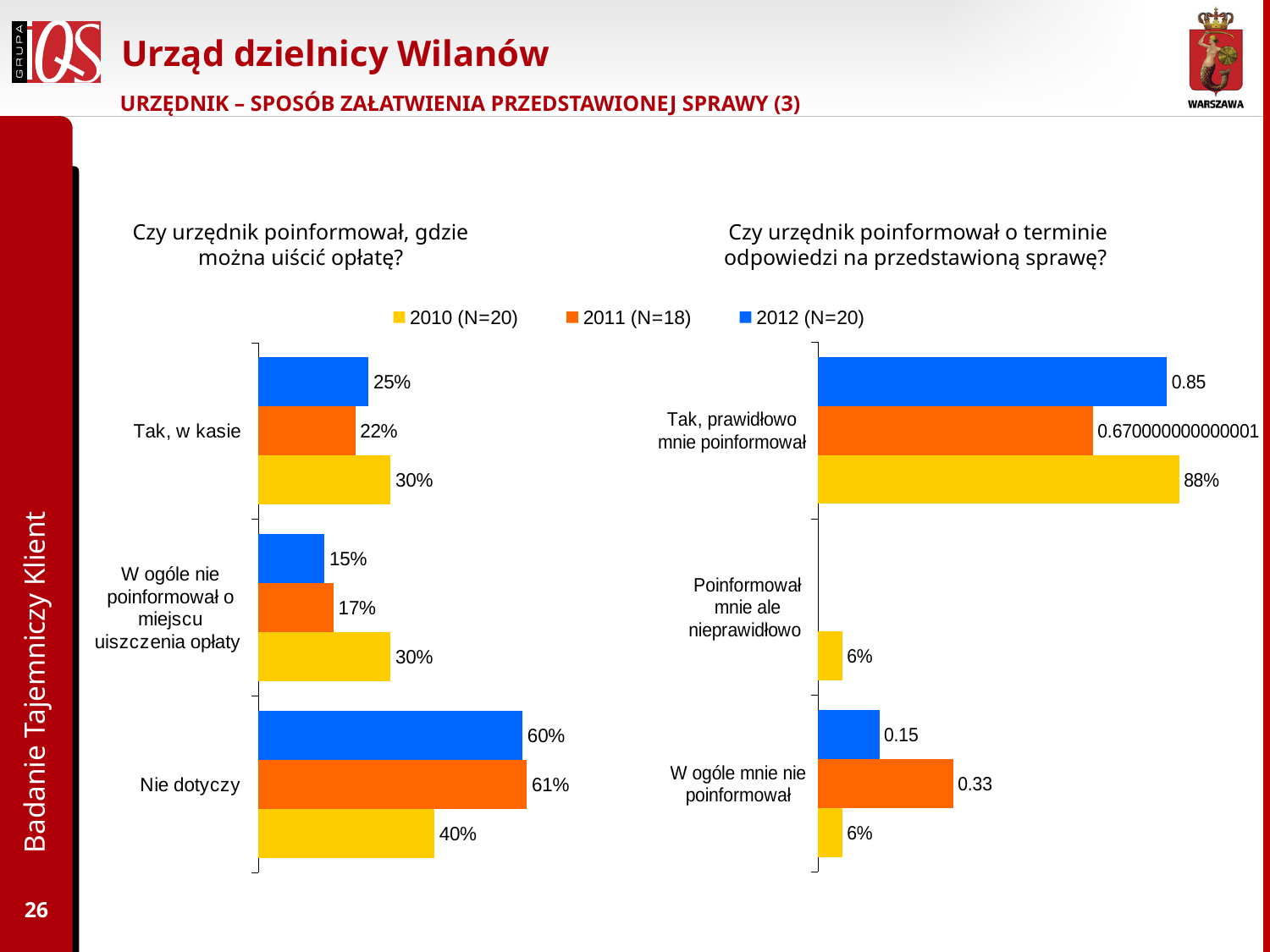
In the right chart (Czy urzędnik poinformował o terminie odpowiedzi na przedstawioną sprawę?), what is the value for 'Tak, prawidłowo mnie poinformował' in 2010 (N=20)? 88% In the left chart (Czy urzędnik poinformował, gdzie można uiścić opłatę?), what is the value for 'W ogóle nie poinformował o miejscu uiszczenia opłaty' in 2010 (N=20)? 30% In the left chart (Czy urzędnik poinformował, gdzie można uiścić opłatę?), what is the value for 'Nie dotyczy' in 2011 (N=18)? 61% In the left chart (Czy urzędnik poinformował, gdzie można uiścić opłatę?), which category has the lowest value for 2011 (N=18)? W ogóle nie poinformował o miejscu uiszczenia opłaty How many categories does the right chart (Czy urzędnik poinformował o terminie odpowiedzi na przedstawioną sprawę?) show? 3 In the left chart (Czy urzędnik poinformował, gdzie można uiścić opłatę?), what is the value for 'Tak, w kasie' in 2012 (N=20)? 25% What kind of chart is the left chart (Czy urzędnik poinformował, gdzie można uiścić opłatę?)? Bar chart In the right chart (Czy urzędnik poinformował o terminie odpowiedzi na przedstawioną sprawę?), what is the value for 'W ogóle mnie nie poinformował' in 2011 (N=18)? 0.33 In the left chart (Czy urzędnik poinformował, gdzie można uiścić opłatę?), which category has the highest value for 2012 (N=20)? Nie dotyczy In the left chart (Czy urzędnik poinformował, gdzie można uiścić opłatę?), what is the difference between the 2010 (N=20) and 2012 (N=20) values for 'Nie dotyczy'? 20% How many series does the legend list? 3 In the right chart (Czy urzędnik poinformował o terminie odpowiedzi na przedstawioną sprawę?), which is larger for 'W ogóle mnie nie poinformował': the 2011 (N=18) value or the 2012 (N=20) value? 2011 (N=18)